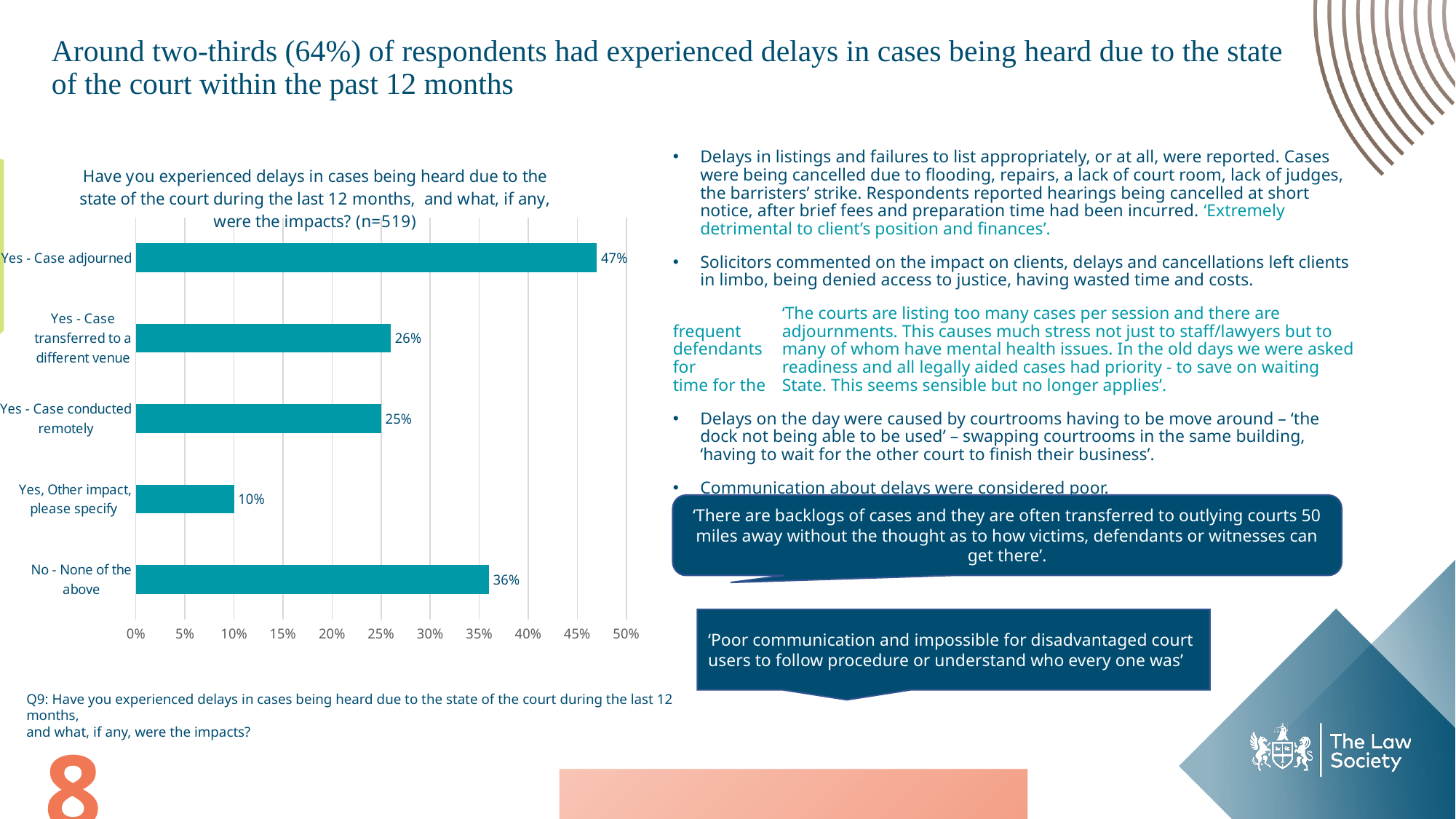
What is the difference between the values for 'Yes - Case adjourned' and 'No - None of the above'? 11% Which category has the lowest value in the chart? Yes, Other impact, please specify Which category has the highest value in the chart? Yes - Case adjourned What percentage of respondents selected 'No - None of the above'? 36% What percentage of respondents selected 'Yes, Other impact, please specify'? 10% What is the sample size (n) stated in the chart title? 519 What percentage of respondents selected 'Yes - Case adjourned'? 47% Is the value for 'Yes - Case adjourned' greater or less than 45%? greater What type of chart is shown on the slide? Bar chart Which is larger: the value for 'Yes - Case conducted remotely' or 'No - None of the above'? No - None of the above How many categories are shown in the bar chart? 5 What percentage of respondents selected 'Yes - Case transferred to a different venue'? 26%